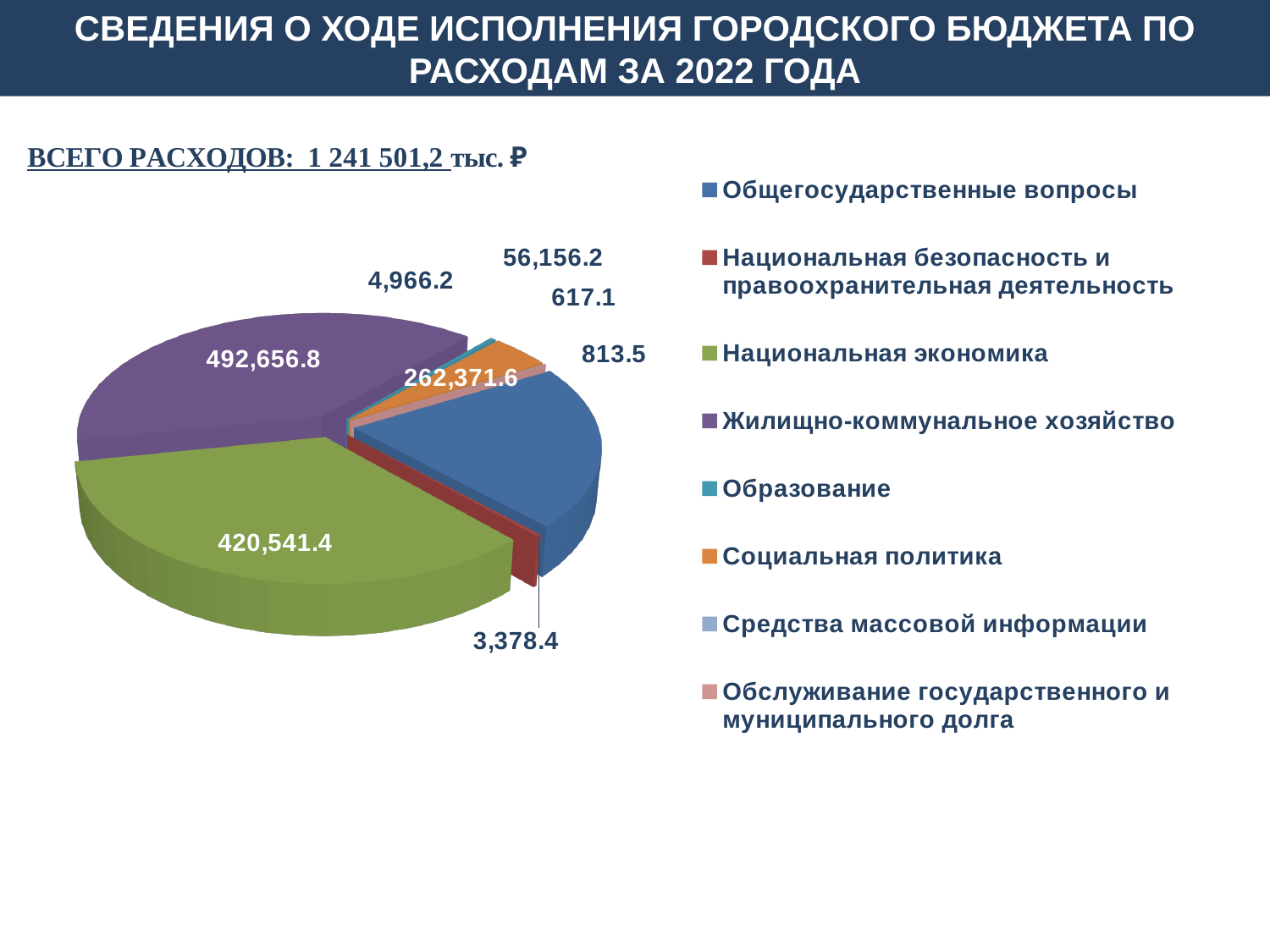
What is the value shown for Национальная безопасность и правоохранительная деятельность? 3,378.4 What kind of chart is shown on the slide? Pie chart What is the value shown for Социальная политика? 56,156.2 What is the difference between the values for Жилищно-коммунальное хозяйство and Национальная экономика? 72,115.4 What total expenditure amount is stated above the chart? 1 241 501,2 тыс. ₽ How many categories does the legend of the pie chart list? 8 Which is larger: the value for Национальная экономика or the value for Общегосударственные вопросы? Национальная экономика Which category has the largest slice in the pie chart? Жилищно-коммунальное хозяйство What is the value shown for Жилищно-коммунальное хозяйство? 492,656.8 What is the value shown for Общегосударственные вопросы? 262,371.6 What is the value shown for Национальная экономика? 420,541.4 What is the smallest data label value shown on the pie chart? 617.1